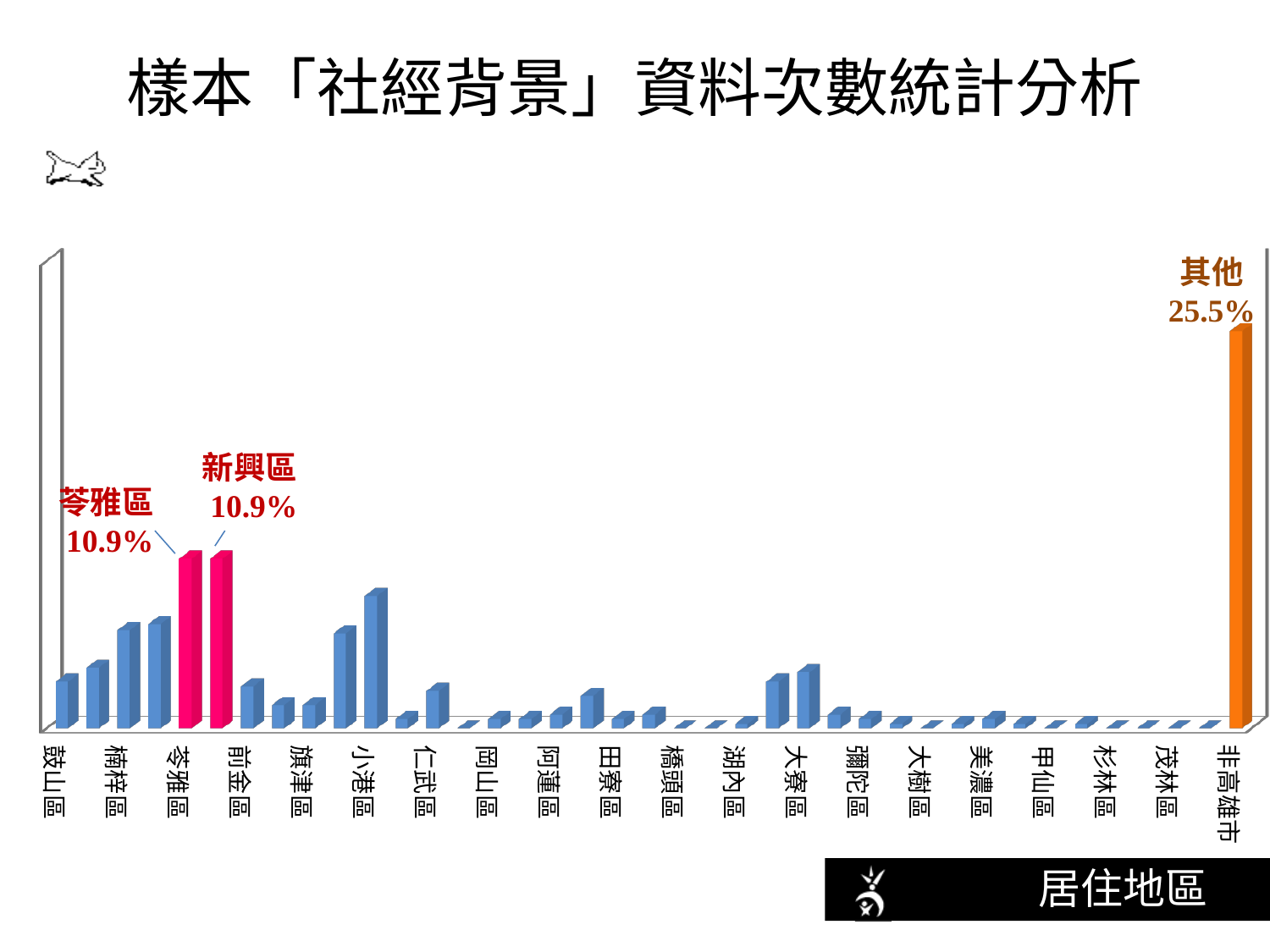
What is the title of the slide? 樣本「社經背景」資料次數統計分析 What is the value labelled for 新興區? 10.9% Which is larger, the value for 其他 or the value for 新興區? 其他 Which category has the highest bar in the chart? 其他 (非高雄市) What is the value labelled for 苓雅區? 10.9% What colour are the highlighted bars for 苓雅區 and 新興區? pink What kind of chart is shown on the slide? bar chart What is the value labelled for 其他 (非高雄市)? 25.5% Which is larger, the bar for 小港區 or the bar for 鼓山區? 小港區 Which is larger, the bar for 苓雅區 or the bar for 小港區? 苓雅區 What is the difference between the value for 其他 (25.5%) and the value for 苓雅區 (10.9%)? 14.6%